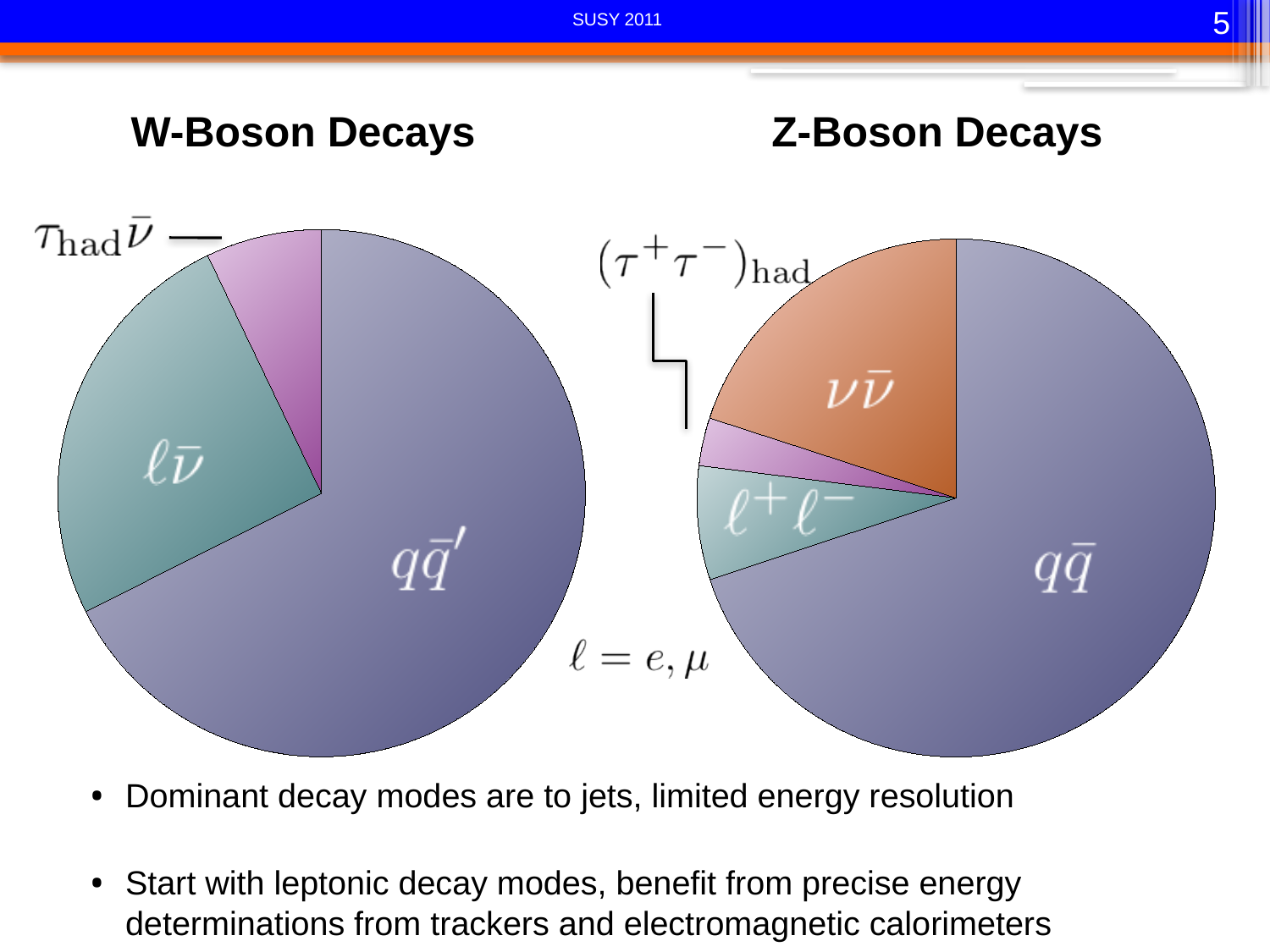
What kind of chart is the W-Boson Decays chart? pie chart What is the title of the pie chart on the right side of the slide? Z-Boson Decays How many slices does the W-Boson Decays pie chart have? 3 In the W-Boson Decays pie chart, which decay mode has the smallest slice? τ_had ν̄ In the W-Boson Decays pie chart, which decay mode has the largest slice? qq̄′ In the Z-Boson Decays pie chart, which decay mode has the smallest slice? (τ⁺τ⁻)_had How many pie charts are shown on the slide? 2 In the Z-Boson Decays pie chart, which slice is larger, νν̄ or ℓ⁺ℓ⁻? νν̄ In the Z-Boson Decays pie chart, which decay mode has the largest slice? qq̄ In the W-Boson Decays pie chart, which slice is larger, ℓν̄ or τ_had ν̄? ℓν̄ How many slices does the Z-Boson Decays pie chart have? 4 What kind of chart is the Z-Boson Decays chart? pie chart